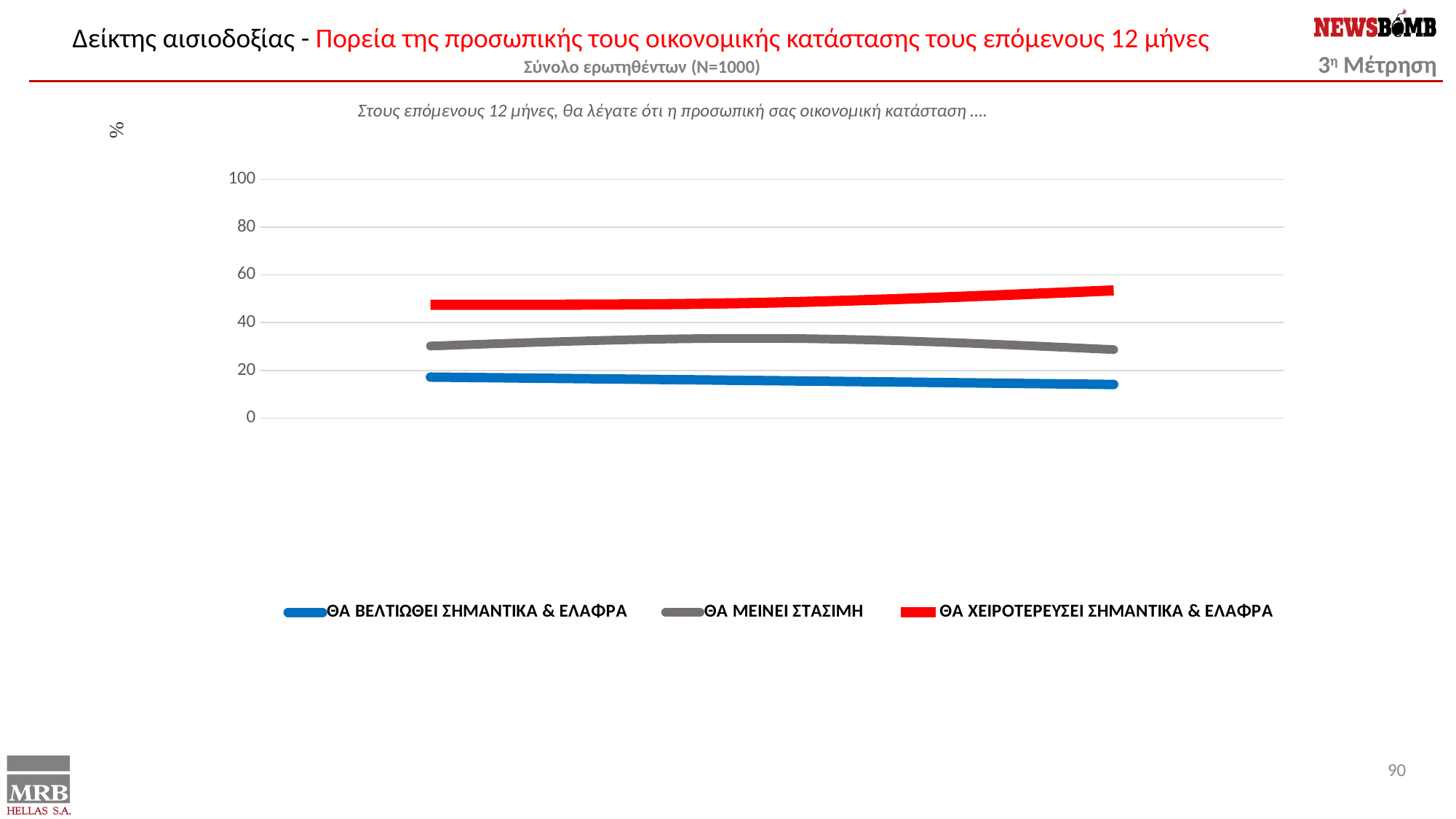
At the right end of the chart, which is larger: ΘΑ ΜΕΙΝΕΙ ΣΤΑΣΙΜΗ or ΘΑ ΧΕΙΡΟΤΕΡΕΥΣΕΙ ΣΗΜΑΝΤΙΚΑ & ΕΛΑΦΡΑ? ΘΑ ΧΕΙΡΟΤΕΡΕΥΣΕΙ ΣΗΜΑΝΤΙΚΑ & ΕΛΑΦΡΑ Is the value for ΘΑ ΒΕΛΤΙΩΘΕΙ ΣΗΜΑΝΤΙΚΑ & ΕΛΑΦΡΑ at the right end of the line greater or less than 20? less Is the value for ΘΑ ΜΕΙΝΕΙ ΣΤΑΣΙΜΗ at the left end of the line greater or less than 20? greater Which series is plotted with the blue line? ΘΑ ΒΕΛΤΙΩΘΕΙ ΣΗΜΑΝΤΙΚΑ & ΕΛΑΦΡΑ Which series is plotted with the red line? ΘΑ ΧΕΙΡΟΤΕΡΕΥΣΕΙ ΣΗΜΑΝΤΙΚΑ & ΕΛΑΦΡΑ What kind of chart is shown on the slide? line chart Does the line for ΘΑ ΧΕΙΡΟΤΕΡΕΥΣΕΙ ΣΗΜΑΝΤΙΚΑ & ΕΛΑΦΡΑ rise or fall from left to right? rise How many series does the legend list? 3 Which series has the lowest values across the whole chart? ΘΑ ΒΕΛΤΙΩΘΕΙ ΣΗΜΑΝΤΙΚΑ & ΕΛΑΦΡΑ Does the line for ΘΑ ΒΕΛΤΙΩΘΕΙ ΣΗΜΑΝΤΙΚΑ & ΕΛΑΦΡΑ rise or fall from left to right? fall Which series has the highest values across the whole chart? ΘΑ ΧΕΙΡΟΤΕΡΕΥΣΕΙ ΣΗΜΑΝΤΙΚΑ & ΕΛΑΦΡΑ Is the value for ΘΑ ΧΕΙΡΟΤΕΡΕΥΣΕΙ ΣΗΜΑΝΤΙΚΑ & ΕΛΑΦΡΑ at the right end of the line greater or less than 40? greater